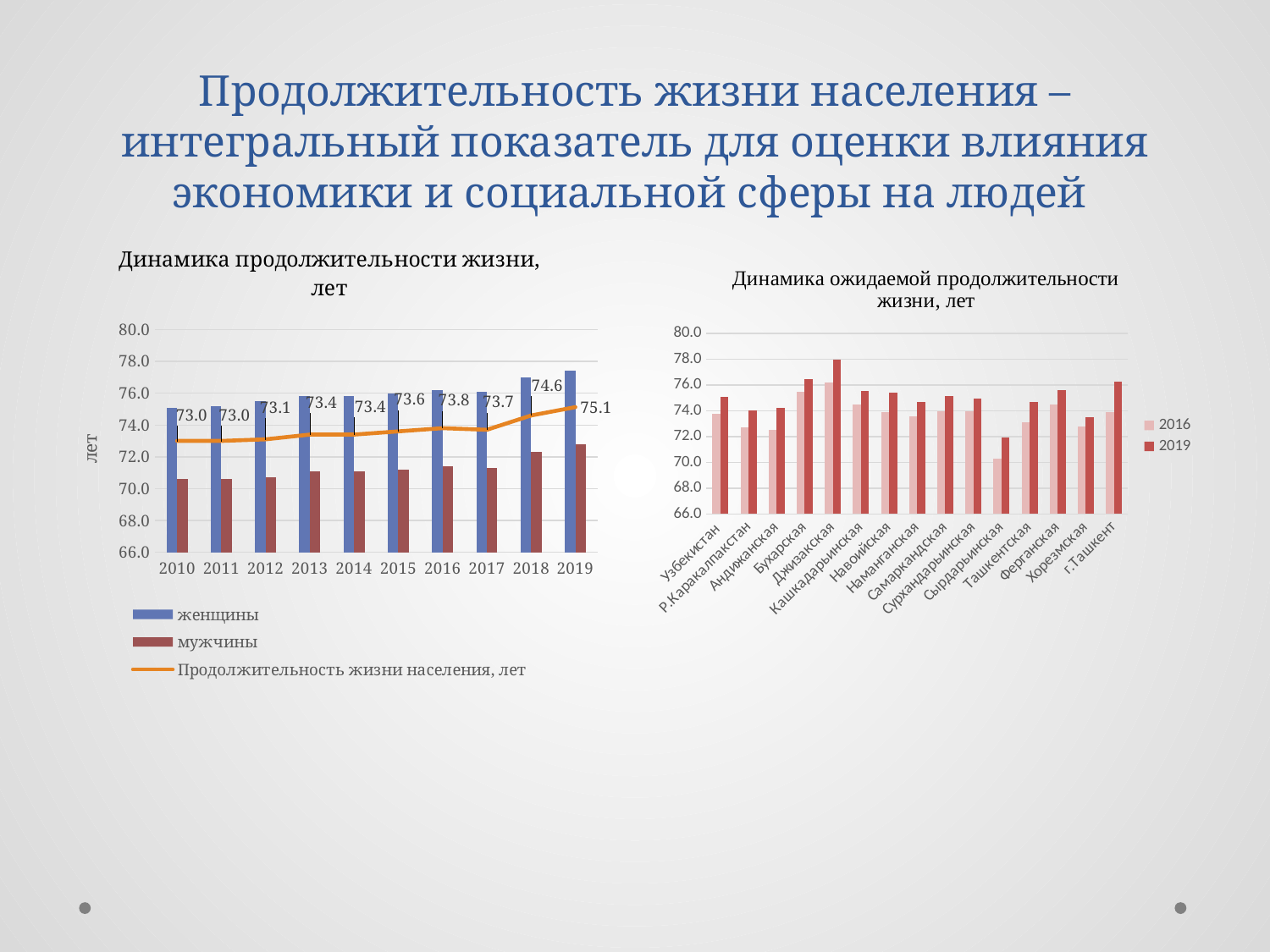
In the right chart 'Динамика ожидаемой продолжительности жизни, лет', is the 2016 value for Сырдарьинская greater or less than 72.0? less In the left chart 'Динамика продолжительности жизни, лет', what is the value of the line 'Продолжительность жизни населения, лет' for 2019? 75.1 In the left chart 'Динамика продолжительности жизни, лет', which is larger in 2019: женщины or мужчины? женщины In the right chart 'Динамика ожидаемой продолжительности жизни, лет', which region has the highest 2019 value? Джизакская In the left chart 'Динамика продолжительности жизни, лет', how many years are shown on the x axis? 10 In the left chart 'Динамика продолжительности жизни, лет', by how much did the line value increase from 2010 to 2019? 2.1 In the left chart 'Динамика продолжительности жизни, лет', in which year is the line 'Продолжительность жизни населения, лет' highest? 2019 In the left chart 'Динамика продолжительности жизни, лет', how many series does the legend list? 3 In the right chart 'Динамика ожидаемой продолжительности жизни, лет', how many series does the legend list? 2 In the right chart 'Динамика ожидаемой продолжительности жизни, лет', how many regions are shown on the x axis? 15 In the left chart 'Динамика продолжительности жизни, лет', what is the value of the line 'Продолжительность жизни населения, лет' for 2010? 73.0 In the left chart 'Динамика продолжительности жизни, лет', does the line 'Продолжительность жизни населения, лет' generally rise or fall from 2010 to 2019? rise